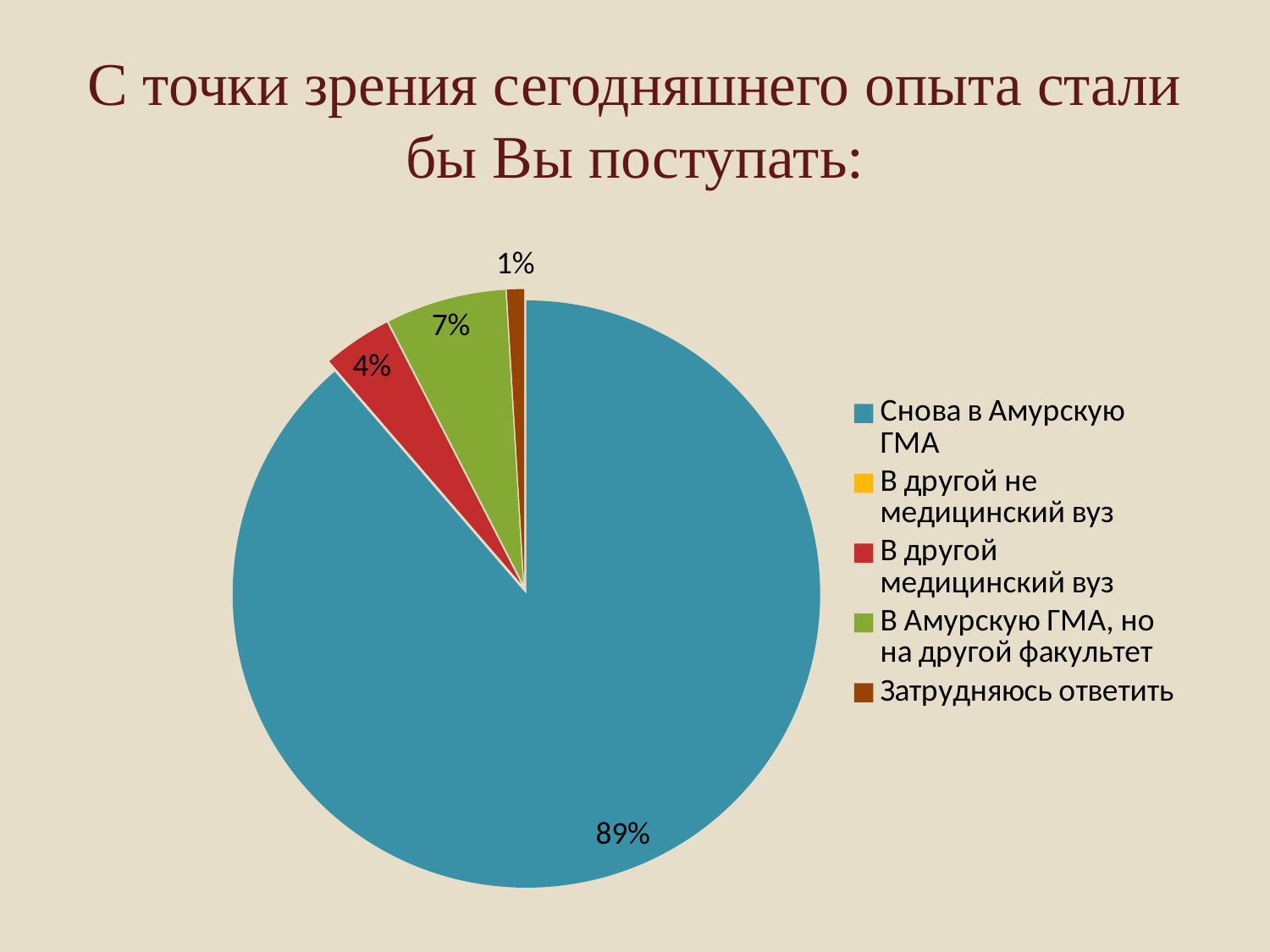
Which is larger: the share for 'В другой медицинский вуз' or for 'В Амурскую ГМА, но на другой факультет'? В Амурскую ГМА, но на другой факультет By how many percentage points does 'Снова в Амурскую ГМА' exceed 'В Амурскую ГМА, но на другой факультет'? 82 percentage points What colour is the slice for 'Снова в Амурскую ГМА'? Blue What share of the pie is labelled for 'В другой медицинский вуз'? 4% Among the slices with a printed percentage, which one is the smallest? Затрудняюсь ответить What percentage is shown for 'В Амурскую ГМА, но на другой факультет'? 7% What is the difference between the shares for 'В Амурскую ГМА, но на другой факультет' and 'В другой медицинский вуз'? 3 percentage points What percentage is shown for 'Затрудняюсь ответить'? 1% What percentage of respondents would enrol again in Амурская ГМА (Снова в Амурскую ГМА)? 89% How many entries does the chart legend list? 5 What type of chart is shown on the slide? Pie chart Which answer option has the largest slice of the pie? Снова в Амурскую ГМА